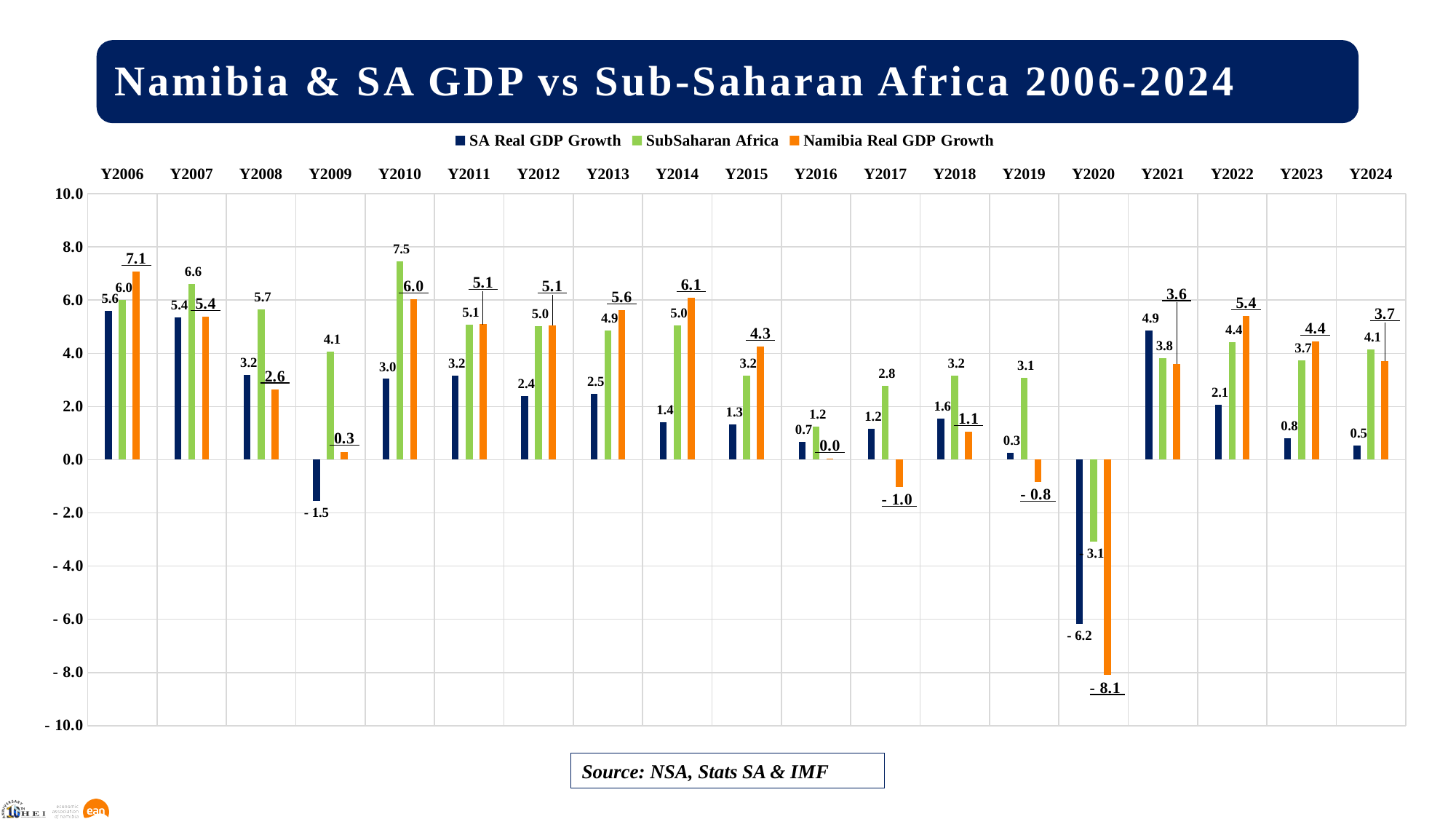
What is the SubSaharan Africa value for Y2010? 7.5 How many series does the legend list? 3 How many years are shown on the x axis? 19 In Y2021, which is larger: SA Real GDP Growth or Namibia Real GDP Growth? SA Real GDP Growth In which year is the Namibia Real GDP Growth value lowest? Y2020 In which year is the SubSaharan Africa value highest? Y2010 What is the SA Real GDP Growth value for Y2020? -6.2 What is the difference between the Namibia Real GDP Growth and SA Real GDP Growth values in Y2014? 4.7 What is the Namibia Real GDP Growth value for Y2017? -1.0 What is the source cited below the chart? NSA, Stats SA & IMF What kind of chart is shown on the slide? Bar chart What is the Namibia Real GDP Growth value for Y2006? 7.1